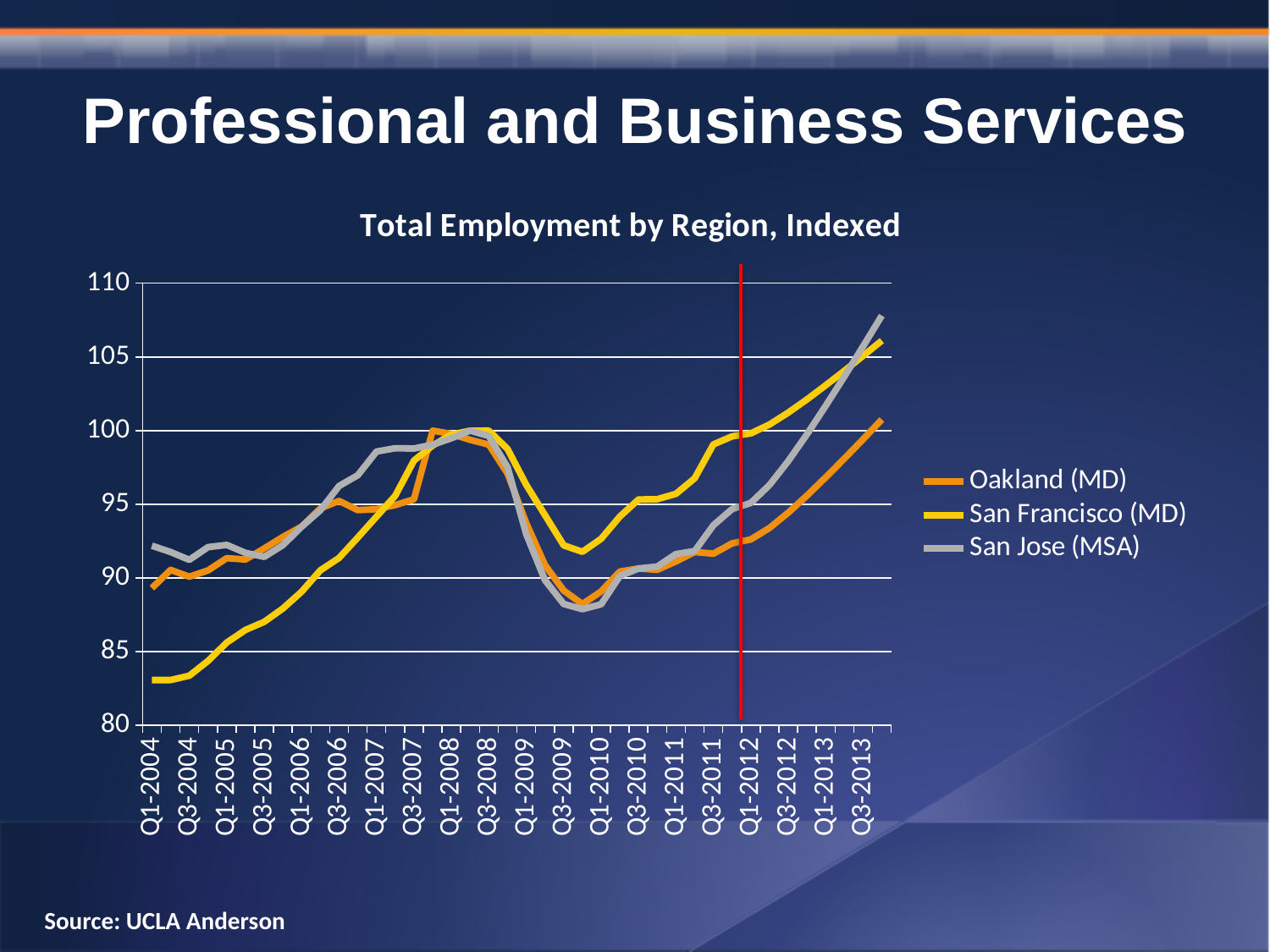
Is the value for San Francisco (MD) at Q3-2011 greater or less than 95? greater At Q1-2004, which is larger: San Jose (MSA) or San Francisco (MD)? San Jose (MSA) Does the Oakland (MD) line rise or fall between Q3-2008 and Q3-2009? fall What kind of chart is shown on the slide? line chart At Q3-2011, which is larger: San Francisco (MD) or Oakland (MD)? San Francisco (MD) What is the title of the chart? Total Employment by Region, Indexed How many series does the legend list? 3 Which series is drawn in gray? San Jose (MSA) Is the value for San Francisco (MD) at Q1-2004 greater or less than 85? less Is the value for San Jose (MSA) at Q3-2013 greater or less than 105? greater Which series has the lowest value at Q1-2004? San Francisco (MD)